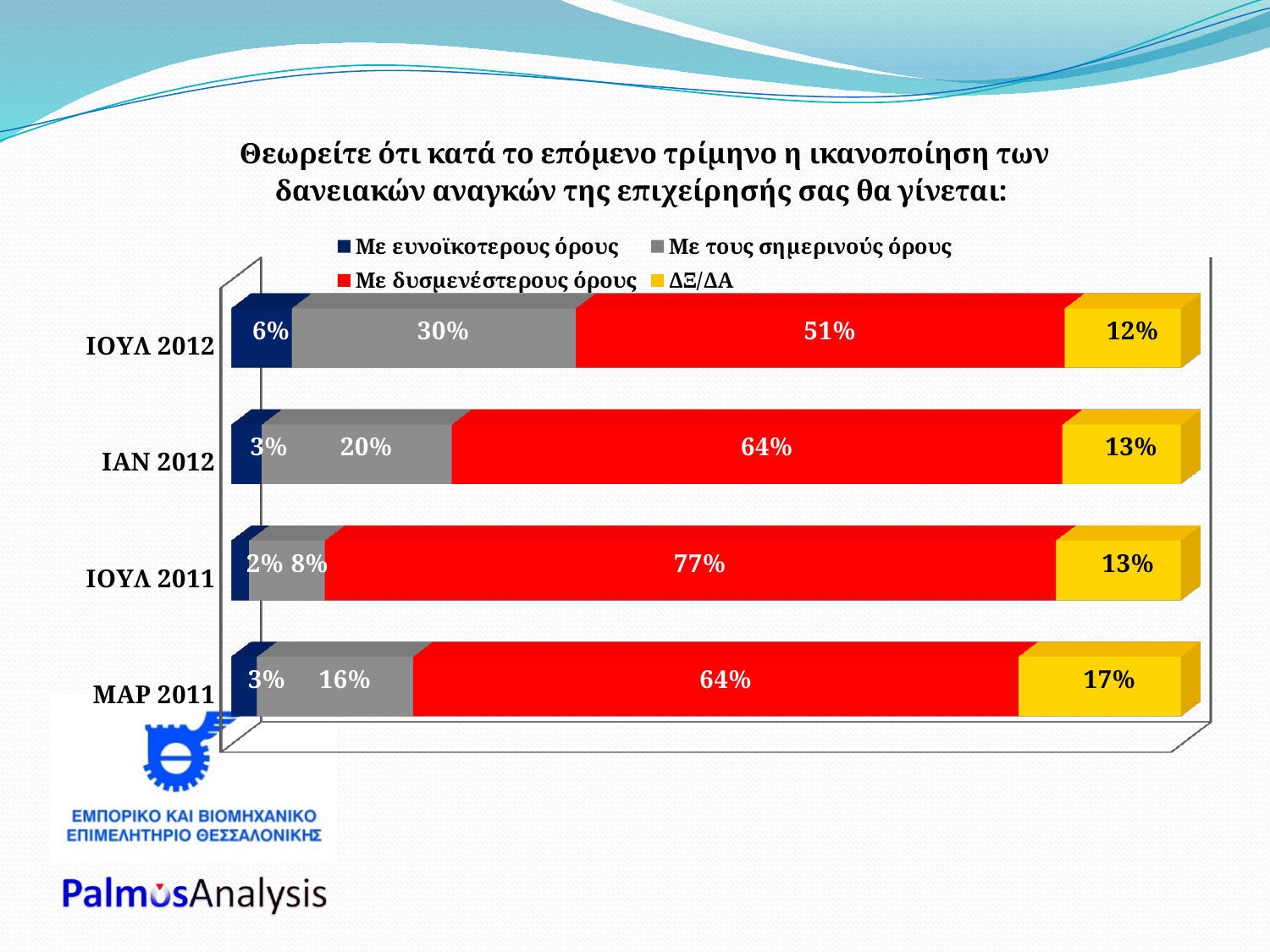
What is the value for "Με τους σημερινούς όρους" in ΙΑΝ 2012? 20% In which period is the "Με τους σημερινούς όρους" share lowest? ΙΟΥΛ 2011 What percentage of respondents in ΙΟΥΛ 2012 answered "Με δυσμενέστερους όρους"? 51% What is the value for "Με ευνοϊκοτερους όρους" in ΙΟΥΛ 2011? 2% Which colour represents "ΔΞ/ΔΑ" in the chart? Yellow How many periods (categories) are shown on the chart? 4 How many series does the legend list? 4 What is the difference between the "Με δυσμενέστερους όρους" values for ΙΟΥΛ 2011 and ΙΟΥΛ 2012? 26 percentage points What kind of chart is shown on the slide? Stacked bar chart Which is larger: the "Με τους σημερινούς όρους" value for ΙΟΥΛ 2012 or for ΜΑΡ 2011? ΙΟΥΛ 2012 What is the ΔΞ/ΔΑ value for ΜΑΡ 2011? 17% In which period is the "Με δυσμενέστερους όρους" share highest? ΙΟΥΛ 2011